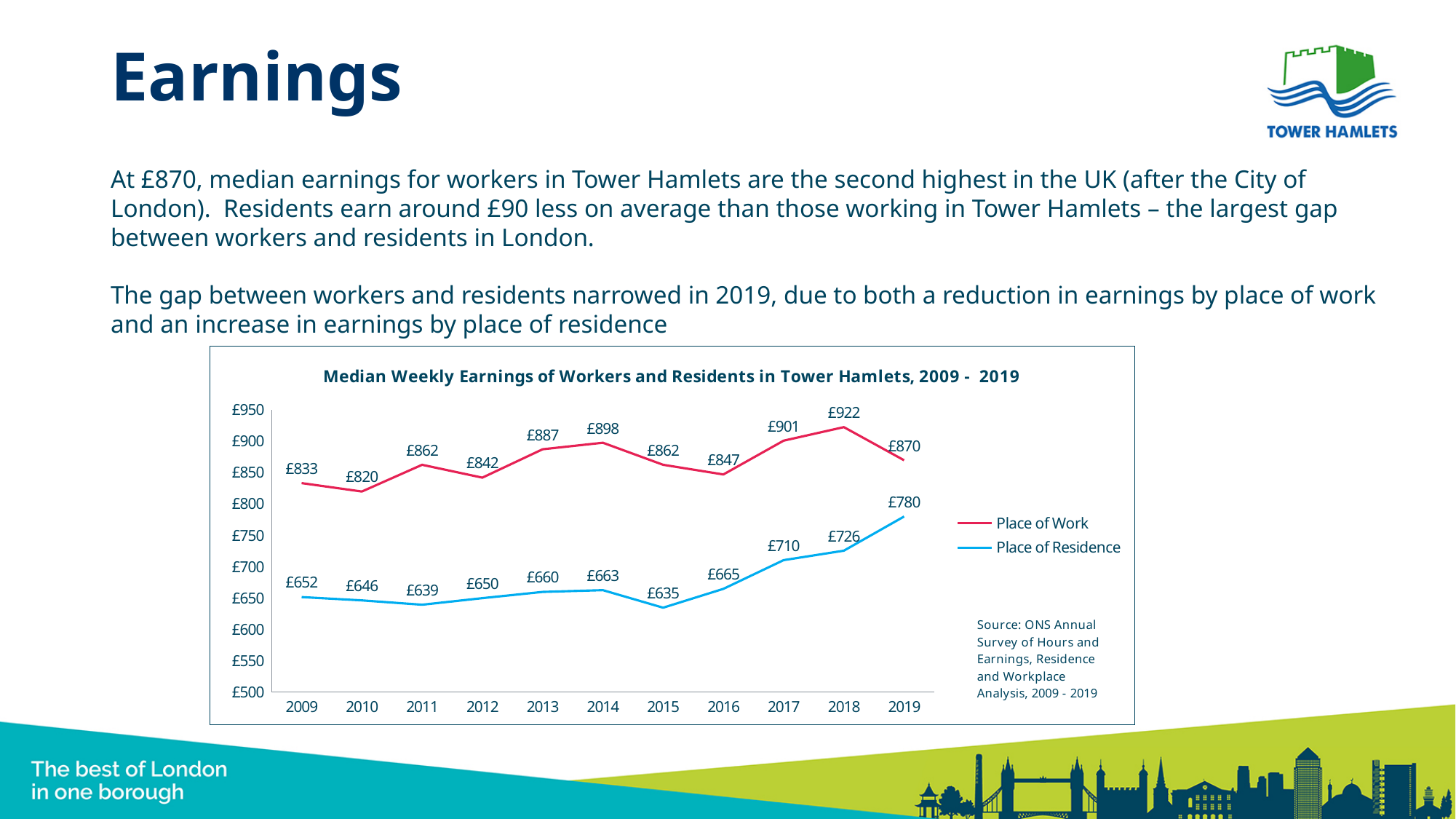
Which colour is used for the Place of Residence line? Blue How many series does the legend list? 2 In which year was the Place of Work value highest? 2018 What is the title of the chart? Median Weekly Earnings of Workers and Residents in Tower Hamlets, 2009 - 2019 What kind of chart is shown on the slide? Line chart How many years are shown on the x axis? 11 Did the Place of Residence value rise or fall between 2015 and 2019? Rise What was the median weekly earnings by Place of Residence in 2015? £635 Which is larger: the Place of Work value in 2014 or in 2017? 2017 What was the median weekly earnings by Place of Work in 2018? £922 What is the difference between the Place of Work and Place of Residence values in 2019? £90 In which year was the Place of Residence value lowest? 2015